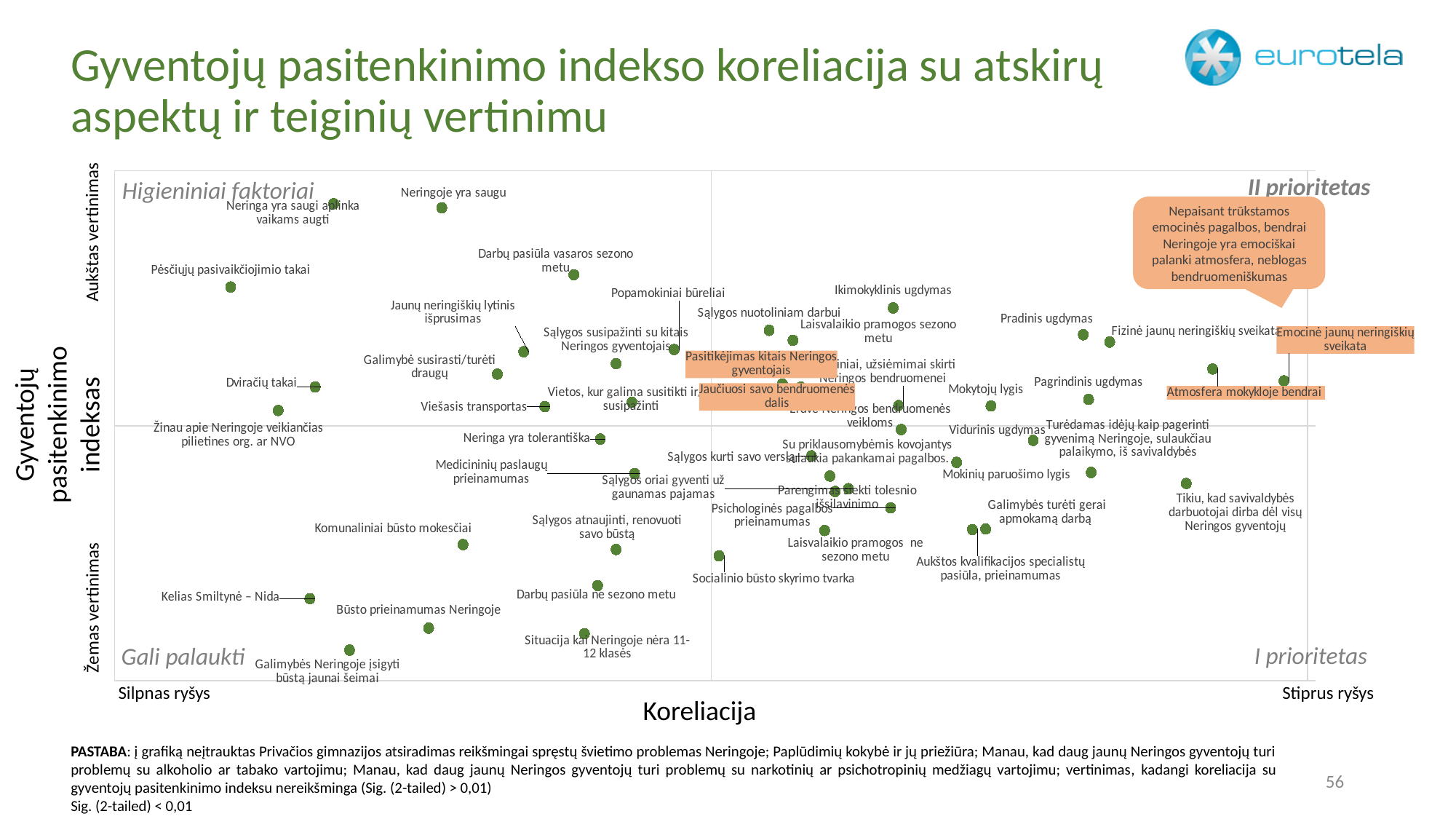
Which point is plotted lowest on the satisfaction index axis? Galimybės Neringoje įsigyti būstą jaunai šeimai In which quadrant of the chart is "Pėsčiųjų pasivaikščiojimo takai" plotted? Higieniniai faktoriai In which quadrant of the chart is "Pradinis ugdymas" plotted? II prioritetas In which quadrant of the chart is "Tikiu, kad savivaldybės darbuotojai dirba dėl visų Neringos gyventojų" plotted? I prioritetas What is the label of the vertical axis of the chart? Gyventojų pasitenkinimo indeksas Which has a higher satisfaction rating on the chart, "Darbų pasiūla vasaros sezono metu" or "Darbų pasiūla ne sezono metu"? Darbų pasiūla vasaros sezono metu Which point is plotted furthest to the left (weakest correlation) on the chart? Pėsčiųjų pasivaikščiojimo takai In which quadrant of the chart is "Komunaliniai būsto mokesčiai" plotted? Gali palaukti What kind of chart is shown on the slide? Scatter plot What is the label of the horizontal axis of the chart? Koreliacija Which has a higher satisfaction rating on the chart, "Neringoje yra saugu" or "Kelias Smiltynė – Nida"? Neringoje yra saugu Which has a stronger correlation on the chart, "Pradinis ugdymas" or "Dviračių takai"? Pradinis ugdymas